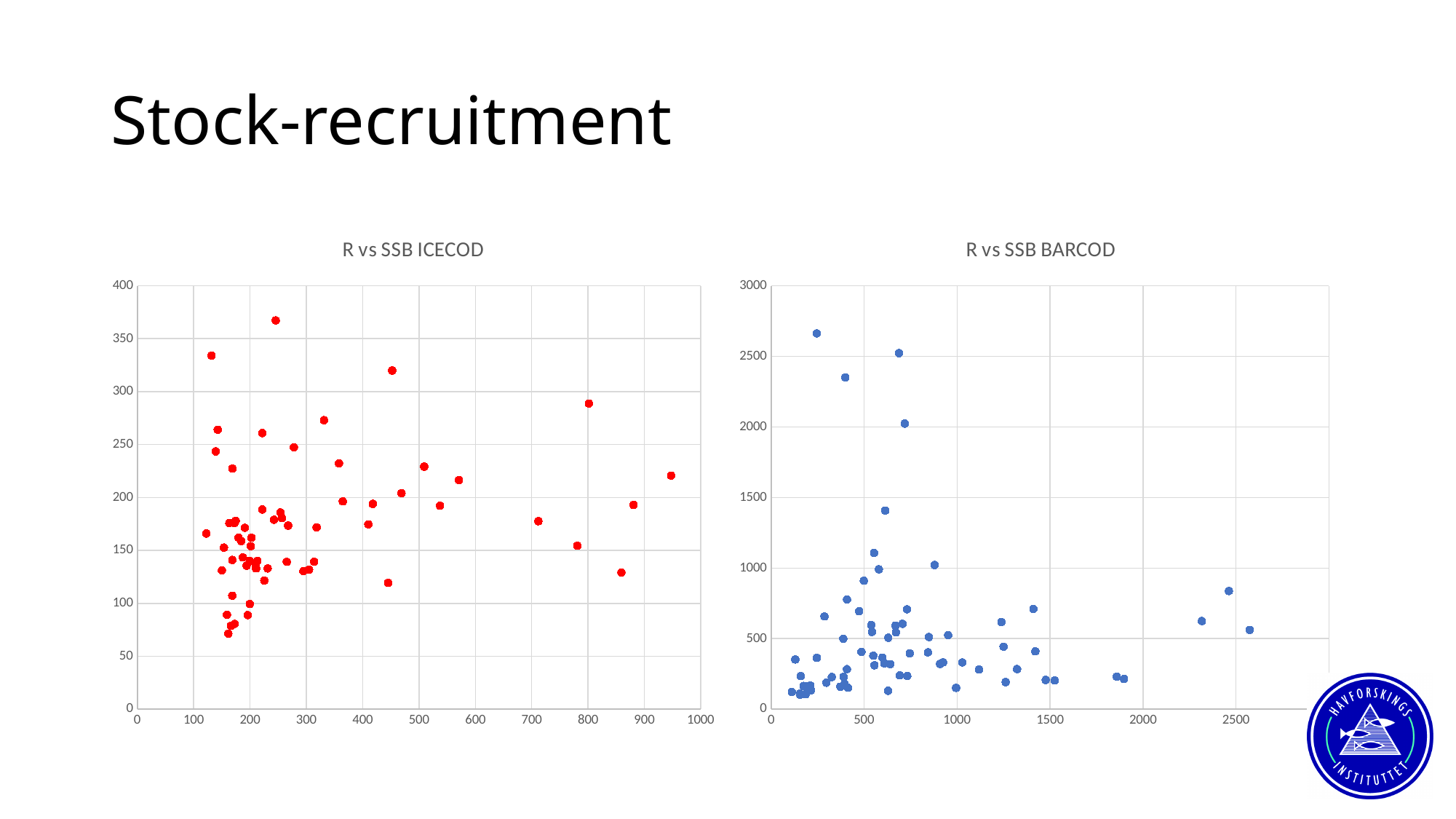
In the 'R vs SSB ICECOD' chart, is the highest plotted point greater or less than 350 on the vertical axis? greater What is the title of the chart on the right side of the slide? R vs SSB BARCOD In the 'R vs SSB BARCOD' chart, is the point with the largest horizontal-axis value greater or less than 1000 on the vertical axis? less In the 'R vs SSB ICECOD' chart, is the point with the largest horizontal-axis value greater or less than 200 on the vertical axis? greater What kind of chart is 'R vs SSB ICECOD'? Scatter chart What colour are the points in the 'R vs SSB ICECOD' chart? Red What kind of chart is 'R vs SSB BARCOD'? Scatter chart